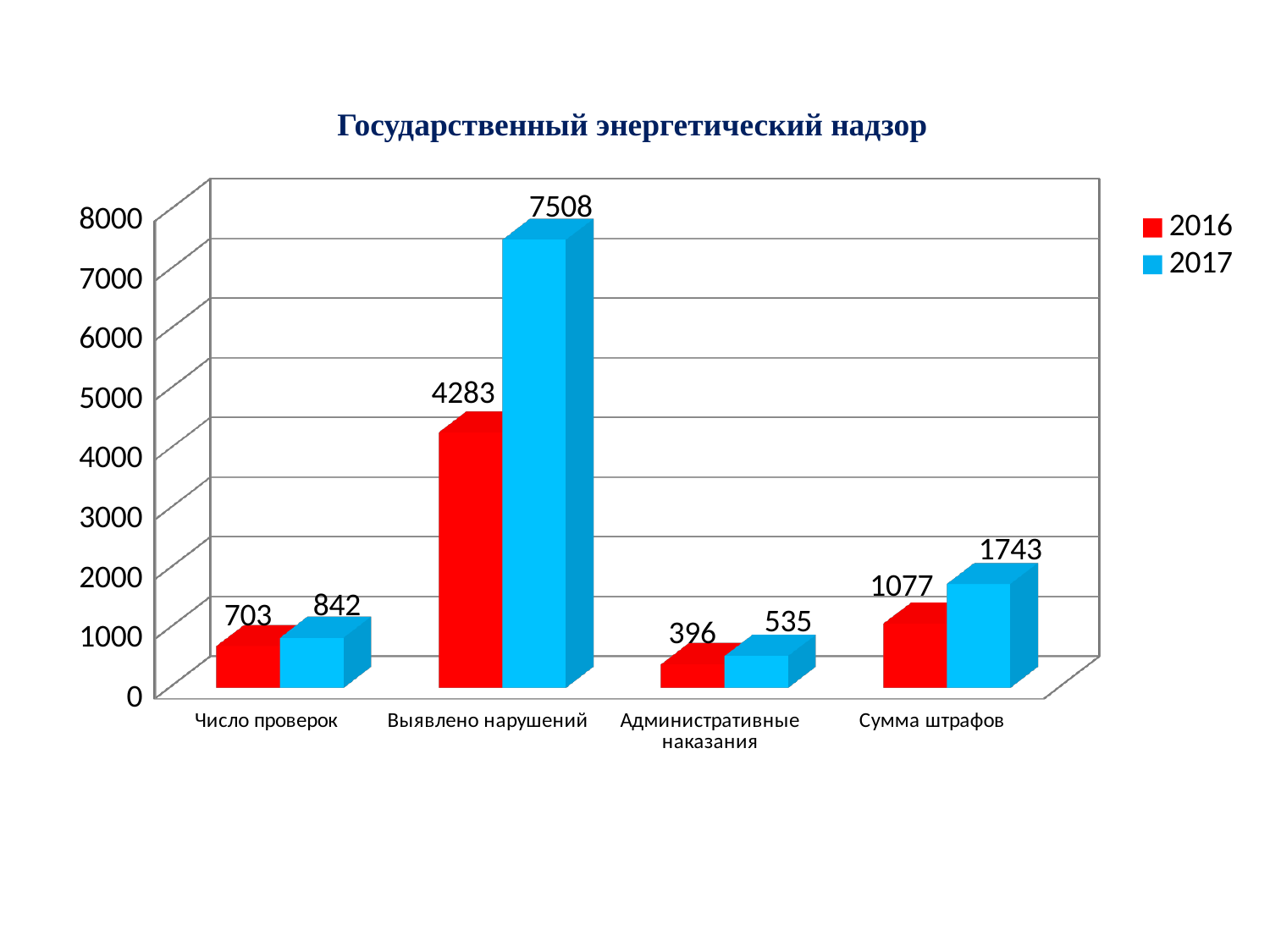
How many categories are shown on the x axis? 4 What kind of chart is shown on the slide? bar chart What is the 2017 value for Выявлено нарушений? 7508 Which category has the highest 2016 value? Выявлено нарушений What is the difference between the 2017 and 2016 values for Число проверок? 139 What is the 2016 value for Административные наказания? 396 How many series does the legend list? 2 Which category has the lowest 2017 value? Административные наказания What is the title of the chart? Государственный энергетический надзор What is the difference between the 2017 and 2016 values for Выявлено нарушений? 3225 What is the 2016 value for Сумма штрафов? 1077 Which is larger for Сумма штрафов, the 2016 value or the 2017 value? 2017